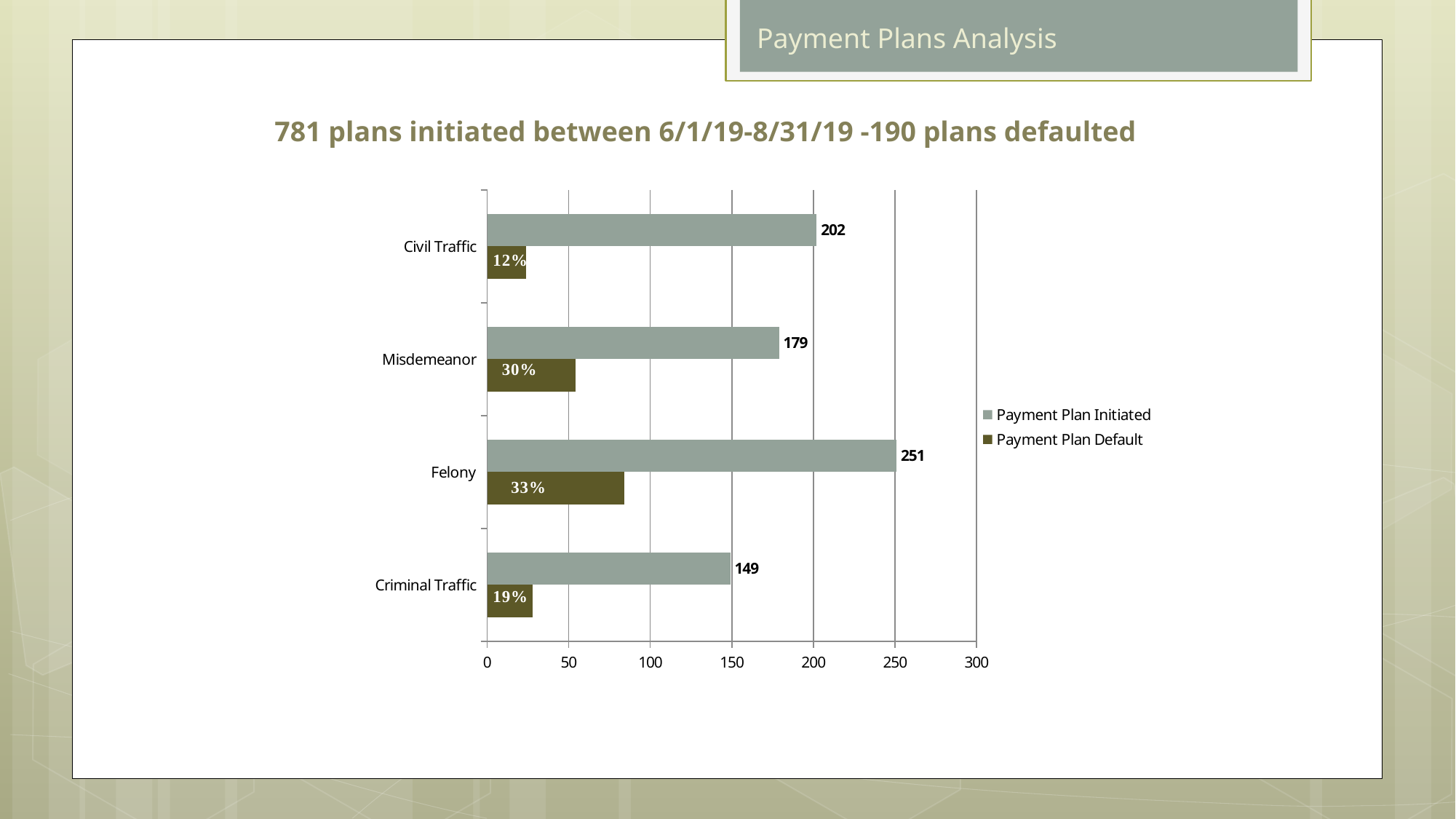
How many series does the legend list? 2 What percentage label is shown on the Payment Plan Default bar for Misdemeanor? 30% What kind of chart is shown on the slide? bar chart What percentage label is shown on the Payment Plan Default bar for Felony? 33% Which category has the highest number of Payment Plans Initiated? Felony How many Payment Plans were Initiated for Civil Traffic? 202 Is the Payment Plan Default bar for Felony greater or less than 100? less What is the difference between Payment Plans Initiated for Felony and for Criminal Traffic? 102 How many Payment Plans were Initiated for Felony? 251 Which has more Payment Plans Initiated, Civil Traffic or Misdemeanor? Civil Traffic Which category has the lowest number of Payment Plans Initiated? Criminal Traffic How many Payment Plans were Initiated for Criminal Traffic? 149